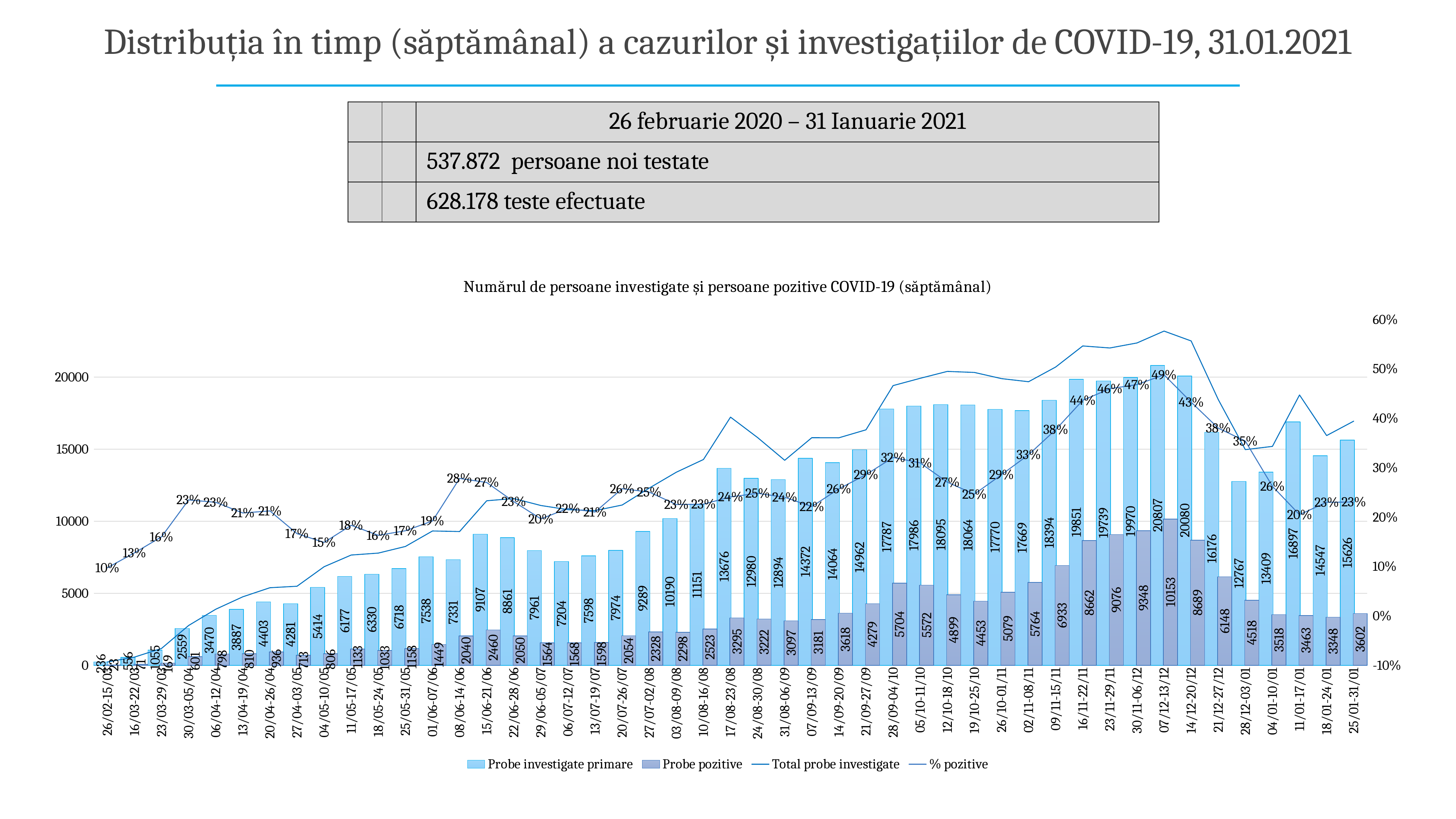
What is the value of Probe investigate primare for the week 07/12-13/12? 20807 How many series does the legend list? 4 Which week has the highest value of Probe investigate primare? 07/12-13/12 Which week has the highest % pozitive value? 07/12-13/12 Which week has a larger value of Probe investigate primare, 17/08-23/08 or 24/08-30/08? 17/08-23/08 What is the difference between Probe investigate primare for 07/12-13/12 and 14/12-20/12? 727 What is the value of Probe pozitive for the week 25/01-31/01? 3602 Which week has the lowest value of Probe investigate primare? 26/02-15/03 What is the % pozitive value for the week 16/11-22/11? 44% Does the % pozitive value rise or fall from 26/02-15/03 to 07/12-13/12? Rise What is the difference between Probe pozitive for 07/12-13/12 and 14/12-20/12? 1464 What kind of chart is shown? Bar chart with line series